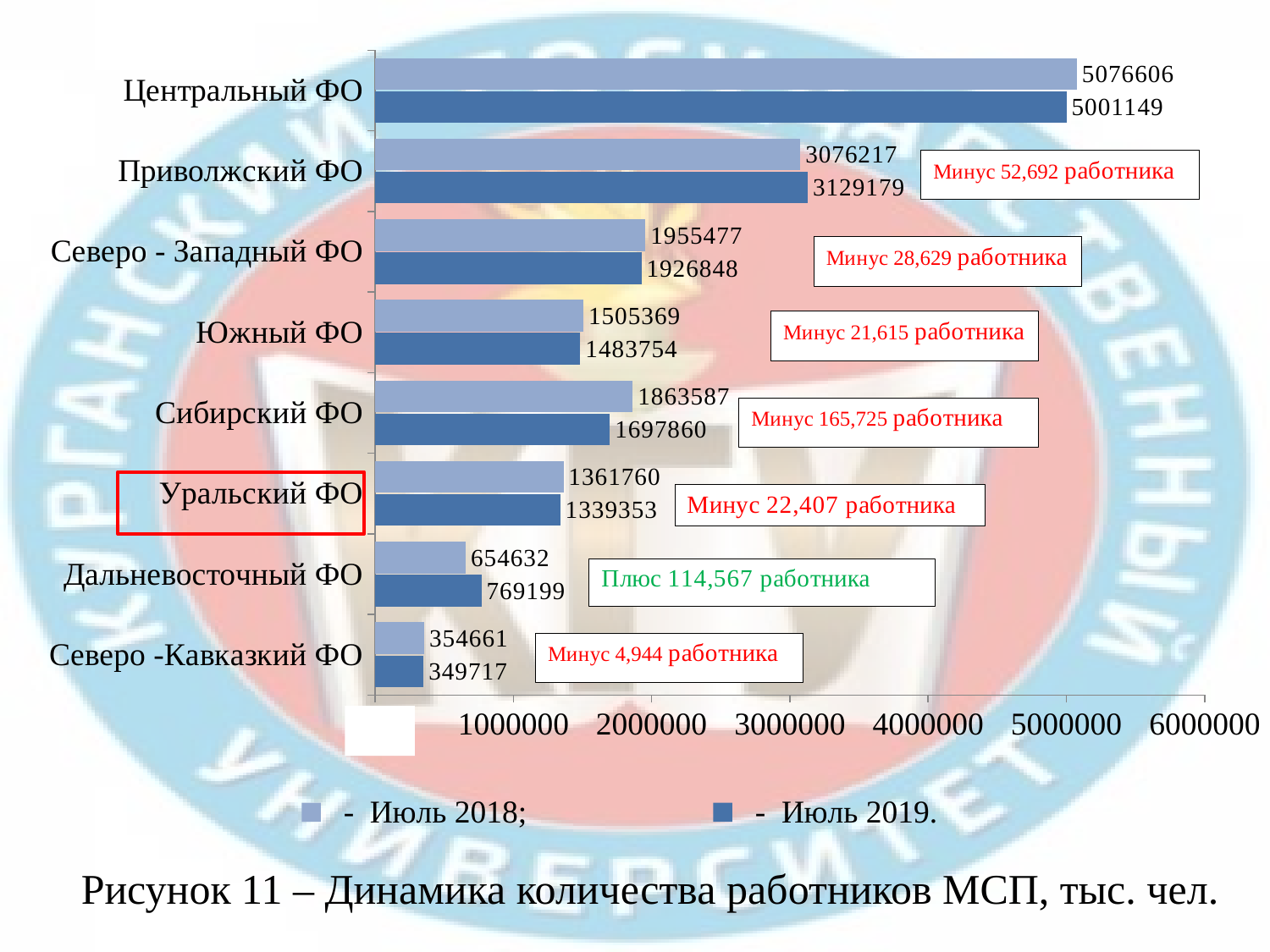
Which category has the highest value in the Июль 2019 series? Центральный ФО What is the value for Северо -Кавказкий ФО in the Июль 2019 series? 349717 Which category has the lowest value in the Июль 2018 series? Северо -Кавказкий ФО What is the value for Дальневосточный ФО in the Июль 2018 series? 654632 What is the difference between the Июль 2018 and Июль 2019 values for Уральский ФО? 22407 What is the value for Приволжский ФО in the Июль 2019 series? 3129179 How many series does the legend list? 2 What is the value for Центральный ФО in the Июль 2018 series? 5076606 How many categories (federal districts) are shown in the chart? 8 What kind of chart is shown on the slide? Bar chart For Приволжский ФО, which series has the larger value, Июль 2018 or Июль 2019? Июль 2019 What is the difference between the Июль 2019 and Июль 2018 values for Дальневосточный ФО? 114567